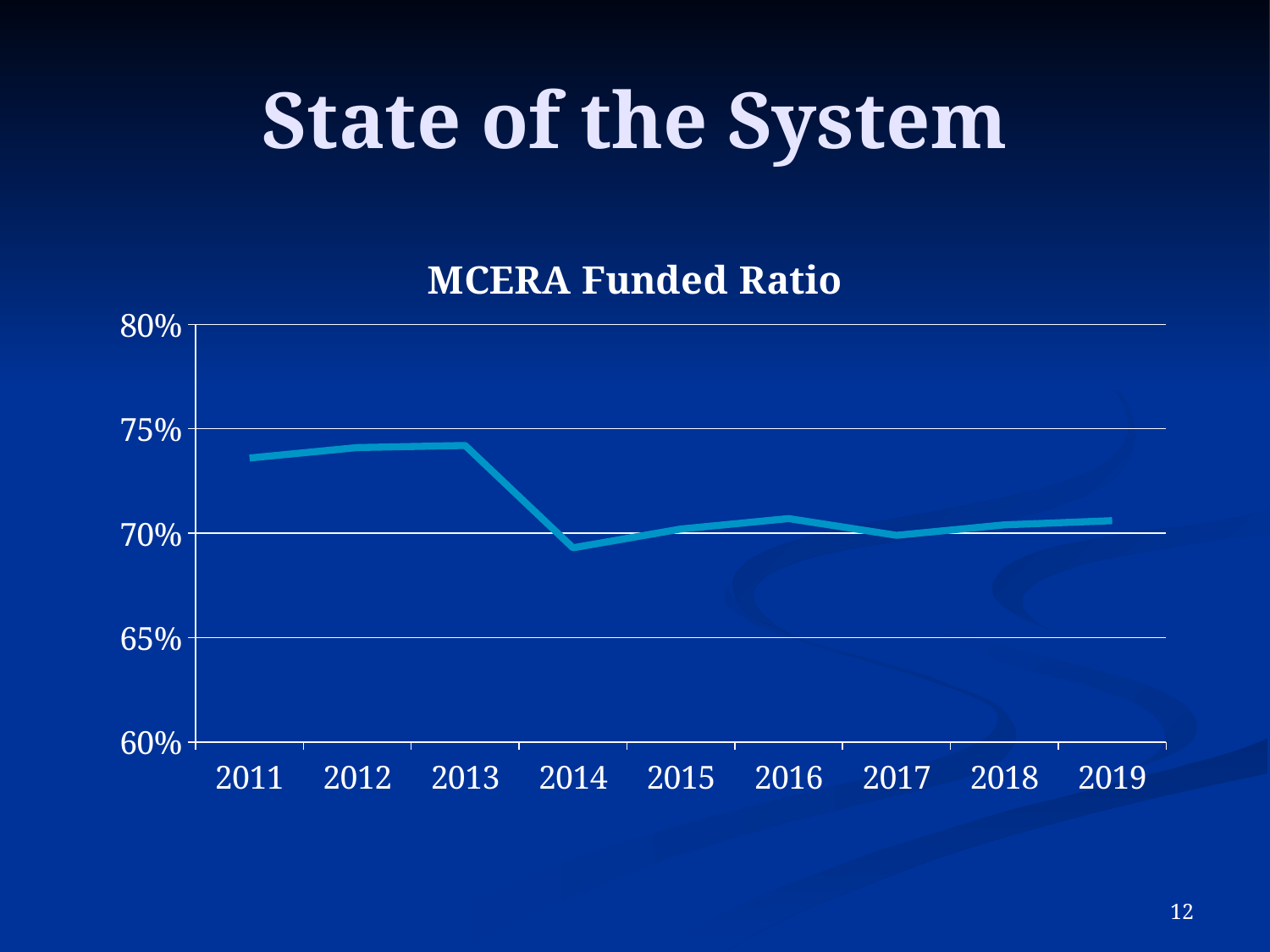
Which year has the higher funded ratio, 2013 or 2014? 2013 How many years are plotted on the x axis of the chart? 9 Which year has the higher funded ratio, 2011 or 2019? 2011 Does the funded ratio rise or fall from 2013 to 2014? fall Which year has the lowest funded ratio in the chart? 2014 Is the funded ratio for 2014 greater or less than 70%? less What is the title of the chart? MCERA Funded Ratio Is the funded ratio for 2011 greater or less than 70%? greater What is the lowest value shown on the y axis of the chart? 60% What type of chart is shown on the slide? line chart Is the funded ratio for 2013 greater or less than 75%? less